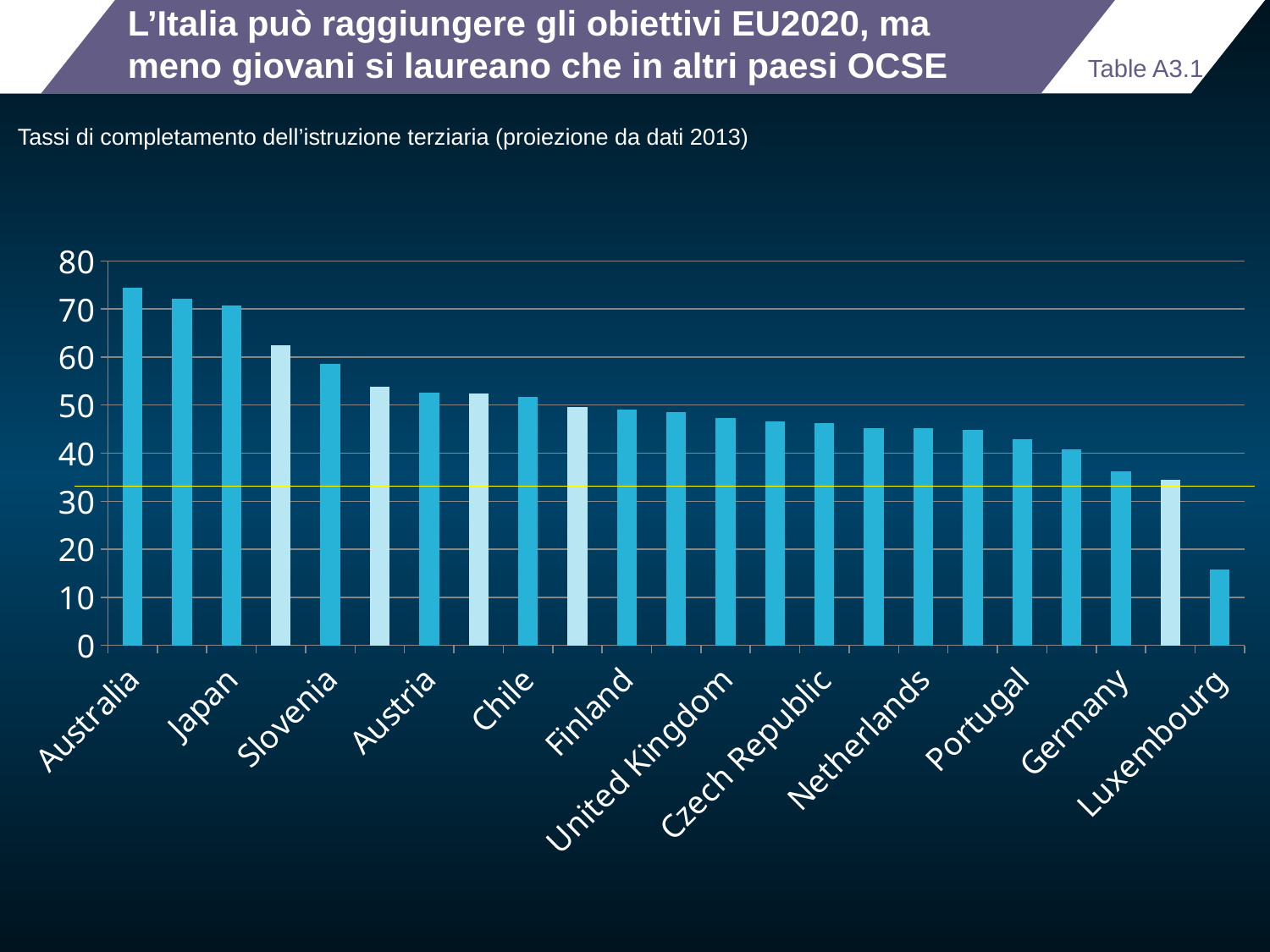
What kind of chart is shown on the slide? bar chart Is the value for Australia greater or less than 70? greater Which country has the highest tertiary completion rate in the chart? Australia Is the value for Luxembourg greater or less than 20? less Which country has the lowest tertiary completion rate in the chart? Luxembourg Is the value for Netherlands greater or less than 50? less What is the subtitle text above the chart? Tassi di completamento dell'istruzione terziaria (proiezione da dati 2013) Do the values rise or fall moving from left to right along the x axis? fall Which has the larger value, Japan or Germany? Japan